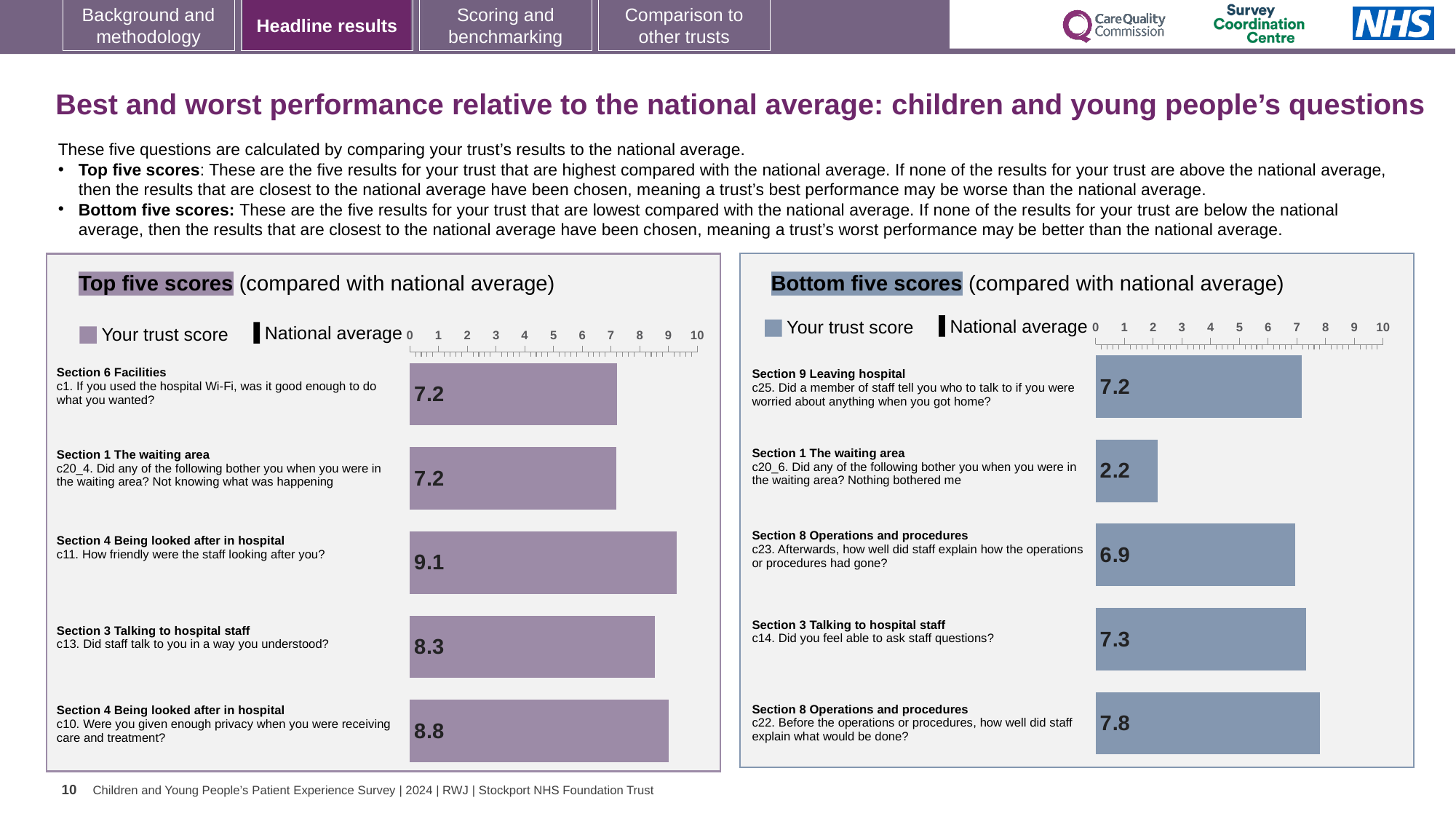
In the Top five scores chart, what is the trust score for c11 'How friendly were the staff looking after you?' 9.1 In the Bottom five scores chart, what is the trust score for c20_6 'Nothing bothered me' in the waiting area? 2.2 In the Top five scores chart, what is the trust score for c10 about being given enough privacy during care and treatment? 8.8 What type of chart is used for the Bottom five scores? Bar chart How many questions are shown as bars in the Top five scores chart? 5 In the Top five scores chart, what is the difference between the scores for c11 (friendly staff) and c13 (staff talked in a way you understood)? 0.8 In the Bottom five scores chart, which question has the lowest trust score? c20_6. Nothing bothered me In the Bottom five scores chart, which has the larger trust score: c14 (able to ask staff questions) or c22 (staff explained what would be done)? c22 In the Top five scores chart, which question has the highest trust score? c11. How friendly were the staff looking after you? What two entries does the legend of the Top five scores chart list? Your trust score; National average In the Bottom five scores chart, what is the difference between the scores for c22 and c23? 0.9 In the Bottom five scores chart, which question has the highest trust score? c22. Before the operations or procedures, how well did staff explain what would be done?